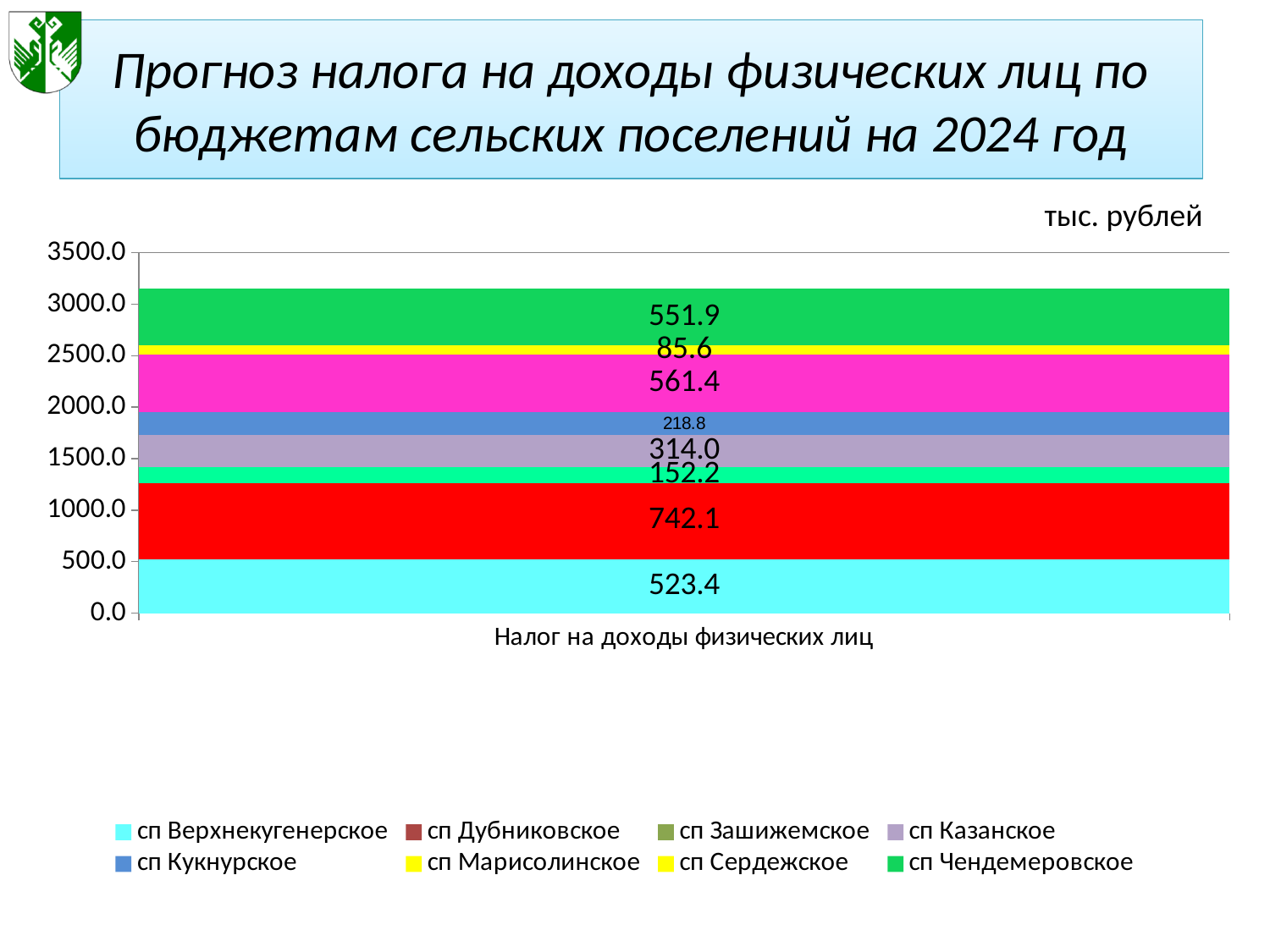
What is the value for сп Верхнекугенерское? 523.4 What unit of measurement is stated above the chart? тыс. рублей What kind of chart is shown on the slide? stacked bar chart What is the value for сп Чендемеровское? 551.9 What is the value for сп Кукнурское? 218.8 Which is larger, the value for сп Чендемеровское or сп Верхнекугенерское? сп Чендемеровское Which series has the largest segment in the stacked bar? сп Дубниковское What is the difference between the values for сп Дубниковское and сп Верхнекугенерское? 218.7 How many series does the legend list? 8 What is the value for сп Казанское? 314.0 What is the smallest value printed on the stacked bar? 85.6 How many categories are shown on the x axis? 1